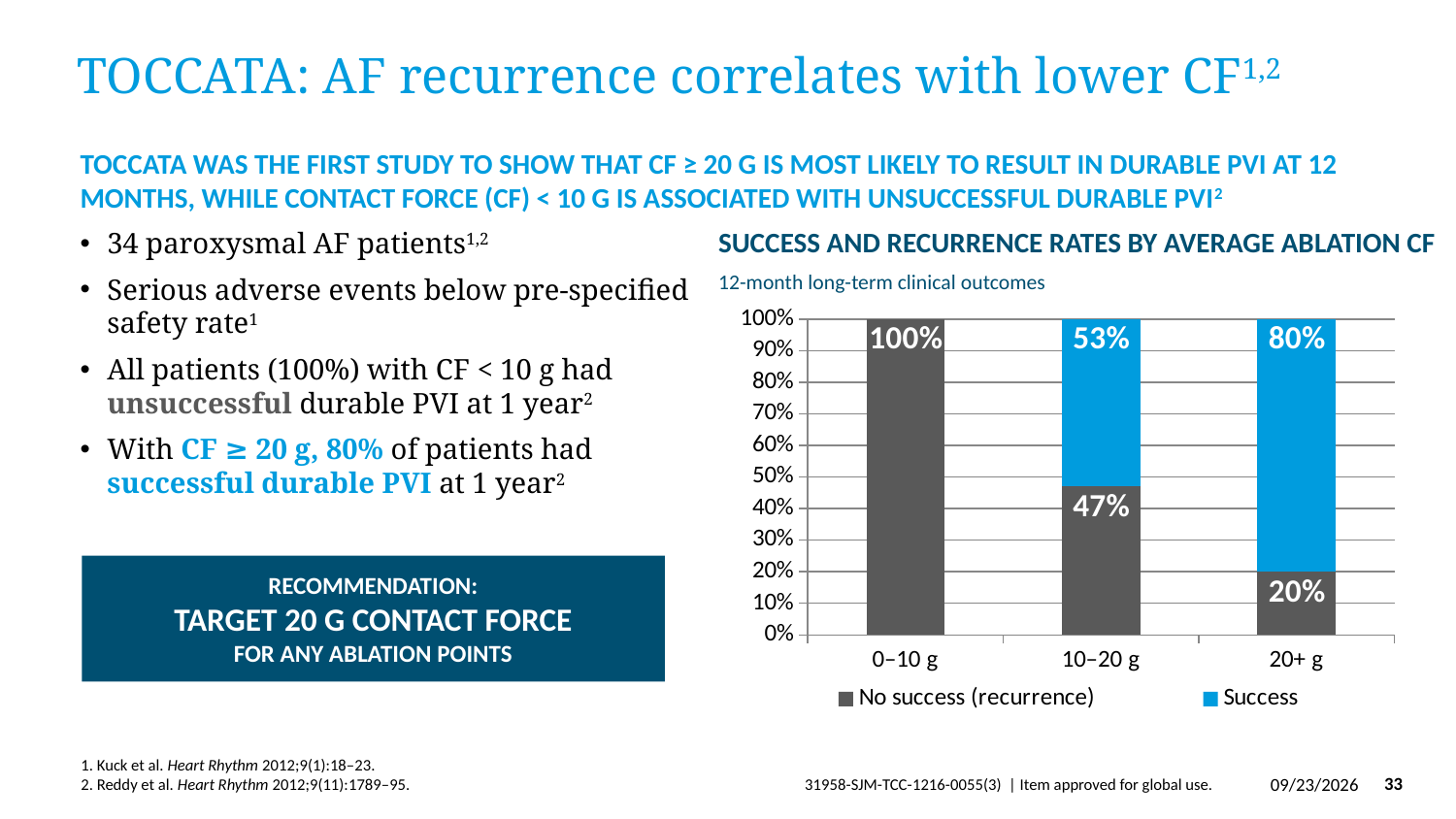
What is the difference between the 'Success' values for 20+ g and 10–20 g? 27% Which is larger: the 'No success (recurrence)' value for 10–20 g or for 20+ g? 10–20 g What is the 'Success' value for the 20+ g category? 80% Which category has the highest 'Success' value? 20+ g What is the title of the chart? Success and recurrence rates by average ablation CF How many categories are shown on the x axis? 3 What type of chart is shown on the slide? Stacked bar chart What is the 'Success' value for the 10–20 g category? 53% What is the 'No success (recurrence)' value for the 0–10 g category? 100% What is the 'No success (recurrence)' value for the 20+ g category? 20% Which category has the lowest 'No success (recurrence)' value? 20+ g How many series does the legend list? 2